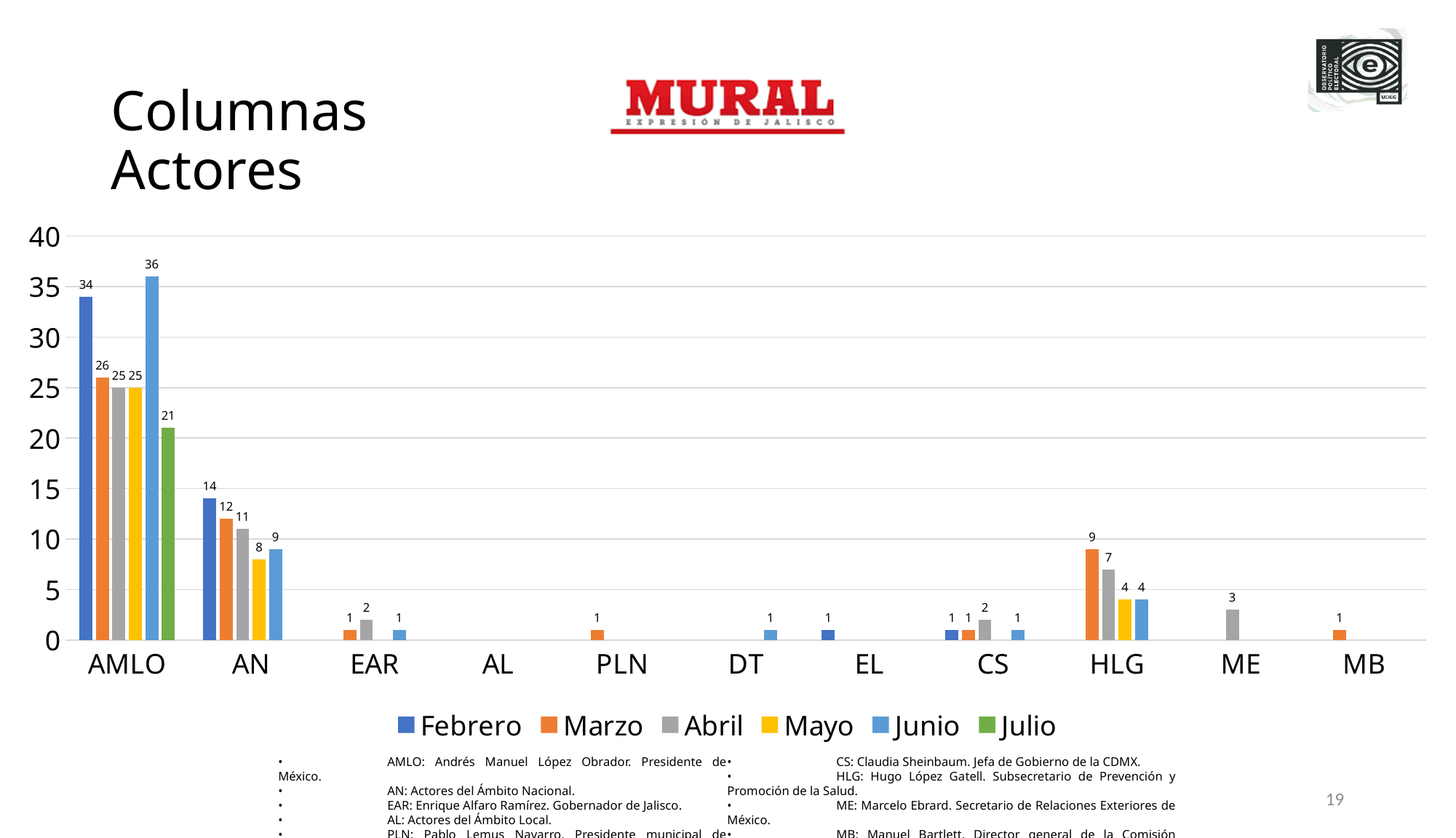
What is the value for ME in Abril? 3 How many series does the legend list? 6 How many categories are shown on the x axis? 11 What is the value for AN in Febrero? 14 Which series is shown in green in the legend? Julio Which month has the lowest value for AN? Mayo What is the difference between the Junio and Julio values for AMLO? 15 Which is larger: the Marzo value for AN or the Marzo value for HLG? Marzo value for AN Which month has the highest value for AMLO? Junio What is the value for AMLO in Junio? 36 What is the value for HLG in Marzo? 9 What kind of chart is shown on the slide? Bar chart